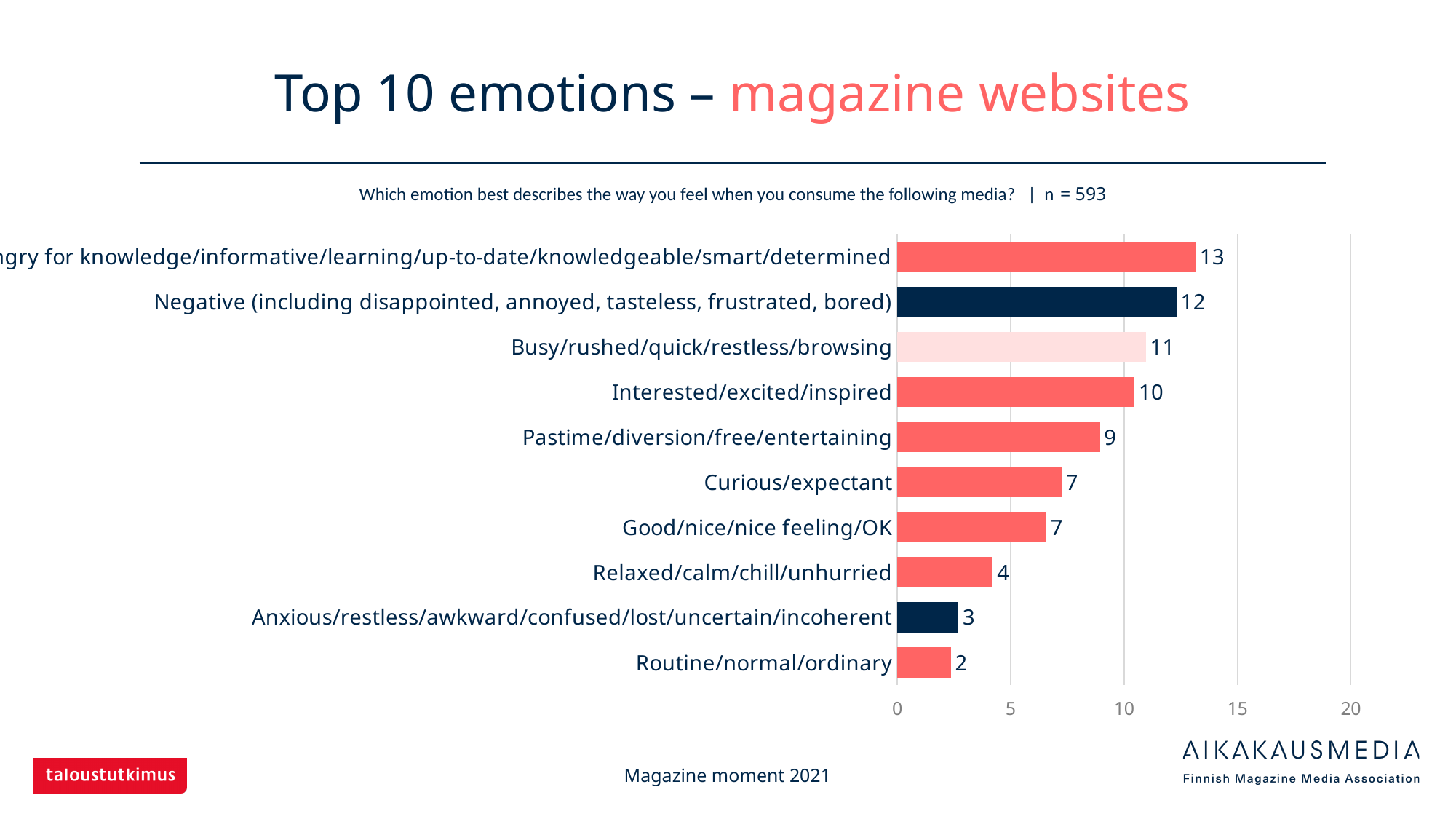
What is the difference between the values for Pastime/diversion/free/entertaining and Anxious/restless/awkward/confused/lost/uncertain/incoherent? 6 Which category has the lowest value? Routine/normal/ordinary What value is shown for Busy/rushed/quick/restless/browsing? 11 What kind of chart is shown on the slide? bar chart Which is larger, the value for Curious/expectant or the value for Relaxed/calm/chill/unhurried? Curious/expectant What value is shown for Interested/excited/inspired? 10 What value is shown for Relaxed/calm/chill/unhurried? 4 Is the value for Negative (including disappointed, annoyed, tasteless, frustrated, bored) greater or less than 10? greater What is the sample size (n) stated on the slide? 593 What value is shown for Negative (including disappointed, annoyed, tasteless, frustrated, bored)? 12 How many categories are shown on the chart? 10 What is the highest value shown on the chart? 13